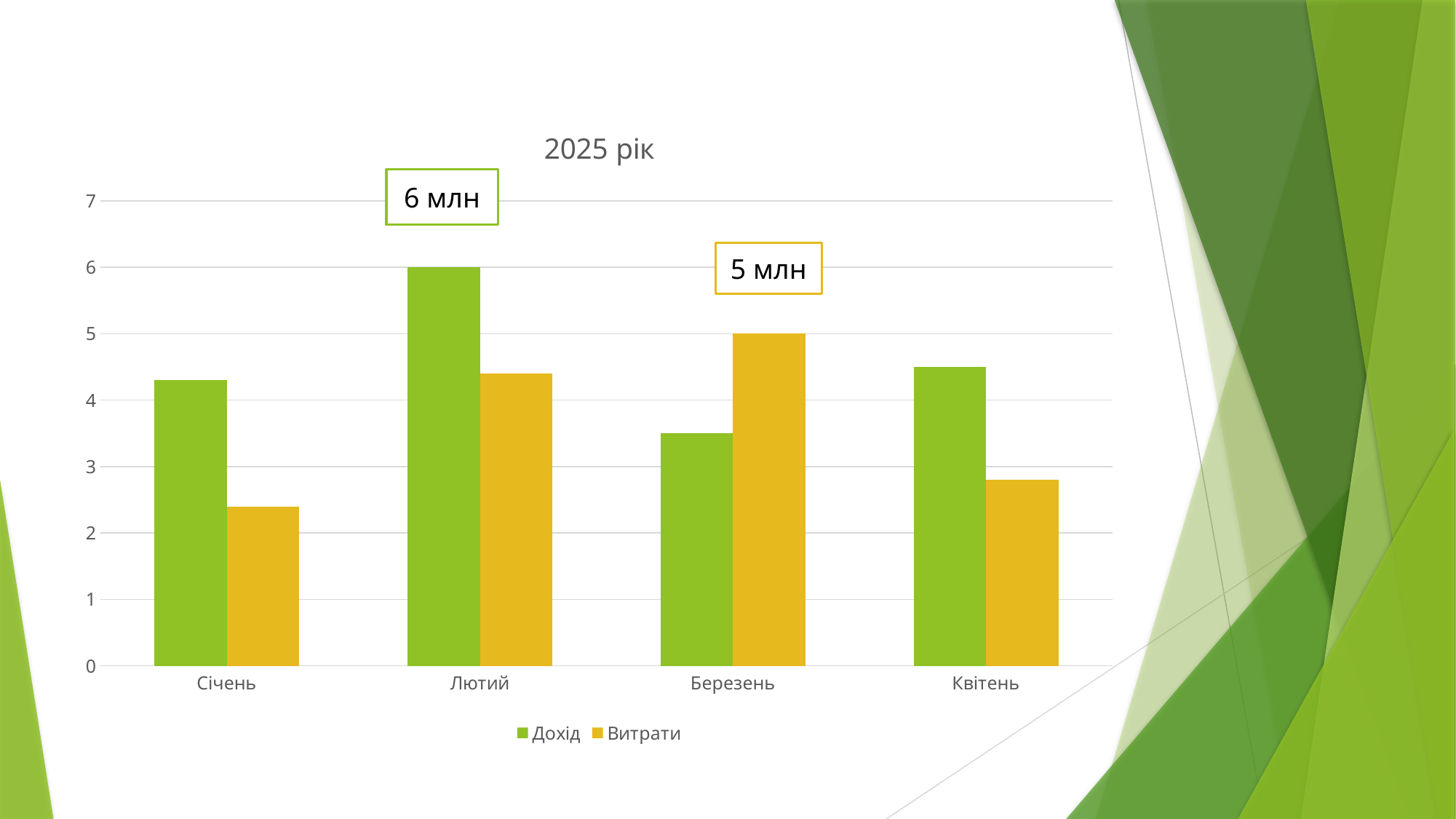
In Березень, which is larger: Дохід or Витрати? Витрати What is the title of the chart? 2025 рік What is the value of Витрати for Березень? 5 млн How many series does the legend list? 2 What is the value of Дохід for Лютий? 6 млн Is the value of Дохід for Січень greater or less than 4? greater What is the difference between Дохід for Лютий and Витрати for Березень? 1 млн In which month is Витрати the lowest? Січень What kind of chart is shown on the slide? Bar chart How many months are shown on the x axis? 4 Is the value of Витрати for Квітень greater or less than 3? less In which month is Дохід the highest? Лютий